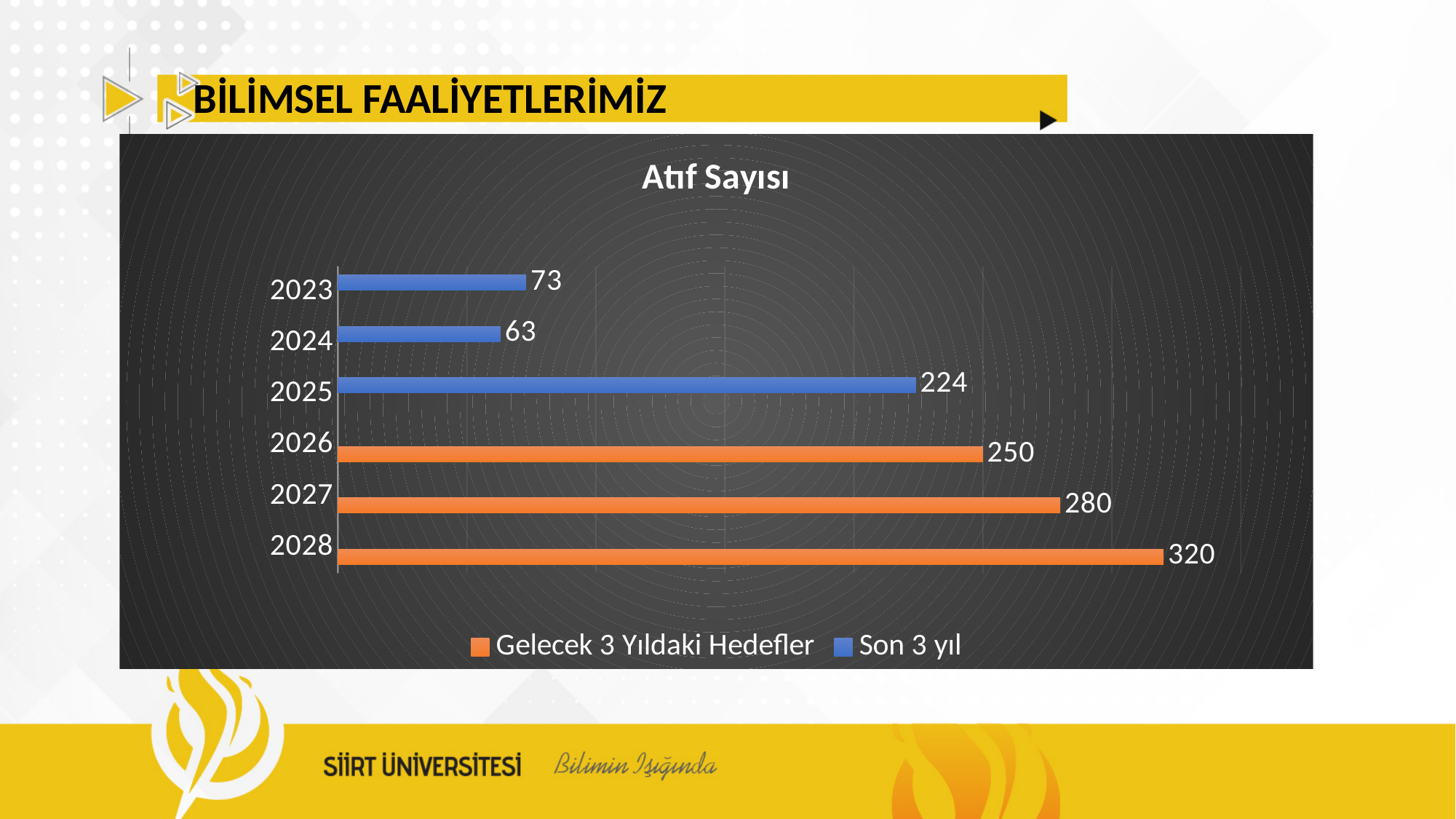
How many series does the legend of the Atıf Sayısı chart list? 2 Which is larger in the Atıf Sayısı chart, the value for 2023 or the value for 2024? 2023 Which series in the Atıf Sayısı chart is shown in orange? Gelecek 3 Yıldaki Hedefler What is the difference between the values for 2028 and 2027 in the Atıf Sayısı chart? 40 Which year has the lowest value in the Atıf Sayısı chart? 2024 What is the value for 2025 in the Atıf Sayısı chart? 224 Which year has the highest value in the Atıf Sayısı chart? 2028 How many years are shown in the Atıf Sayısı chart? 6 What is the value for 2028 in the Atıf Sayısı chart? 320 What is the difference between the values for 2025 and 2024 in the Atıf Sayısı chart? 161 What is the value for 2023 in the Atıf Sayısı chart? 73 What kind of chart is the Atıf Sayısı chart? Bar chart